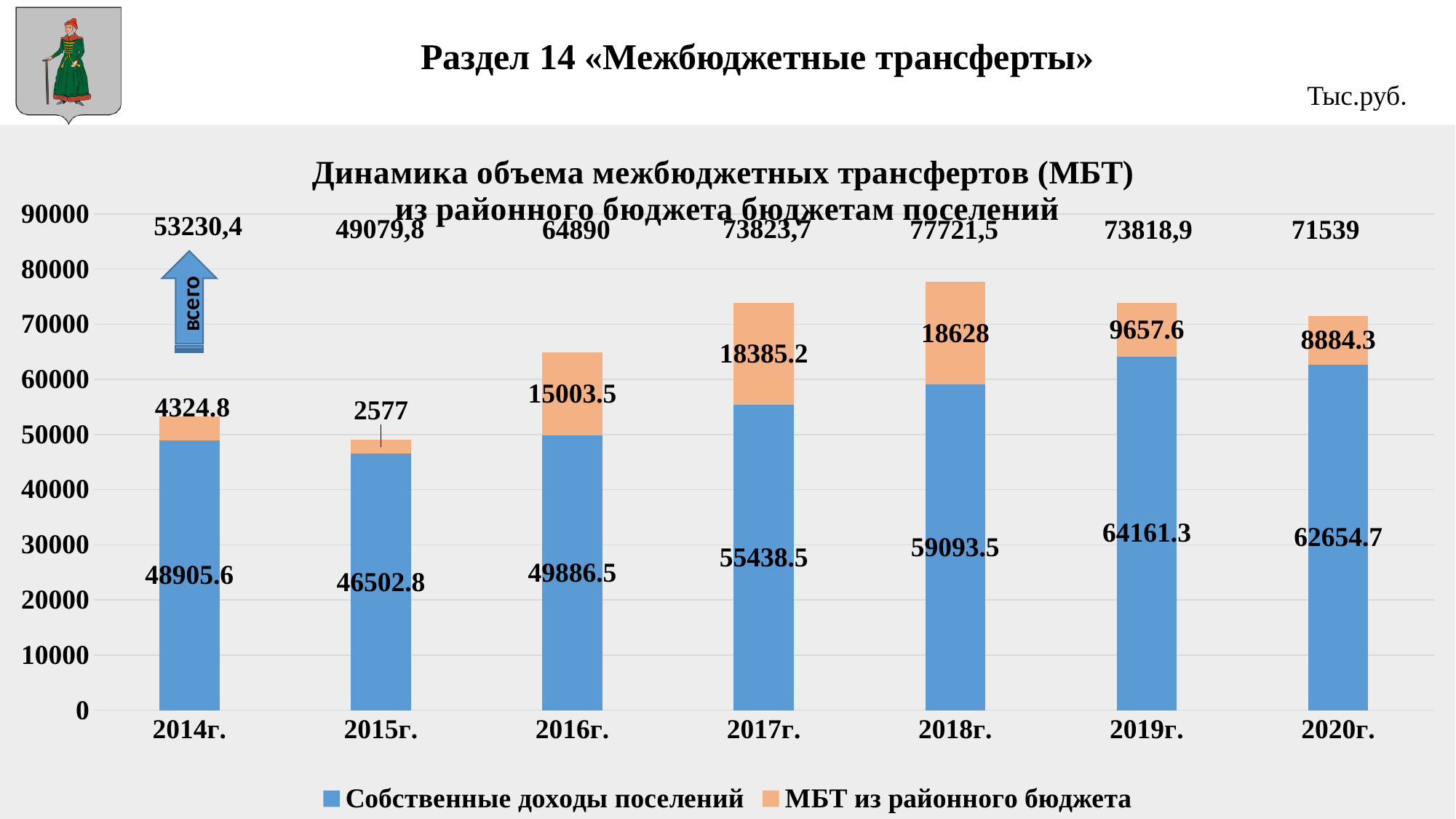
In which year is Собственные доходы поселений the highest? 2019г. How many series does the legend list? 2 What kind of chart is shown on the slide? Stacked bar chart In which year is МБТ из районного бюджета the lowest? 2015г. In which year is МБТ из районного бюджета the highest? 2018г. What is the total (всего) shown above the bar for 2016г.? 64890 What is the value of МБТ из районного бюджета for 2018г.? 18628 Which year has the larger value of Собственные доходы поселений, 2014г. or 2015г.? 2014г. What is the total of the stacked bar for 2020г.? 71539 How many years are shown on the x axis? 7 What is the value of Собственные доходы поселений for 2017г.? 55438.5 What is the difference between МБТ из районного бюджета in 2017г. and 2016г.? 3381.7